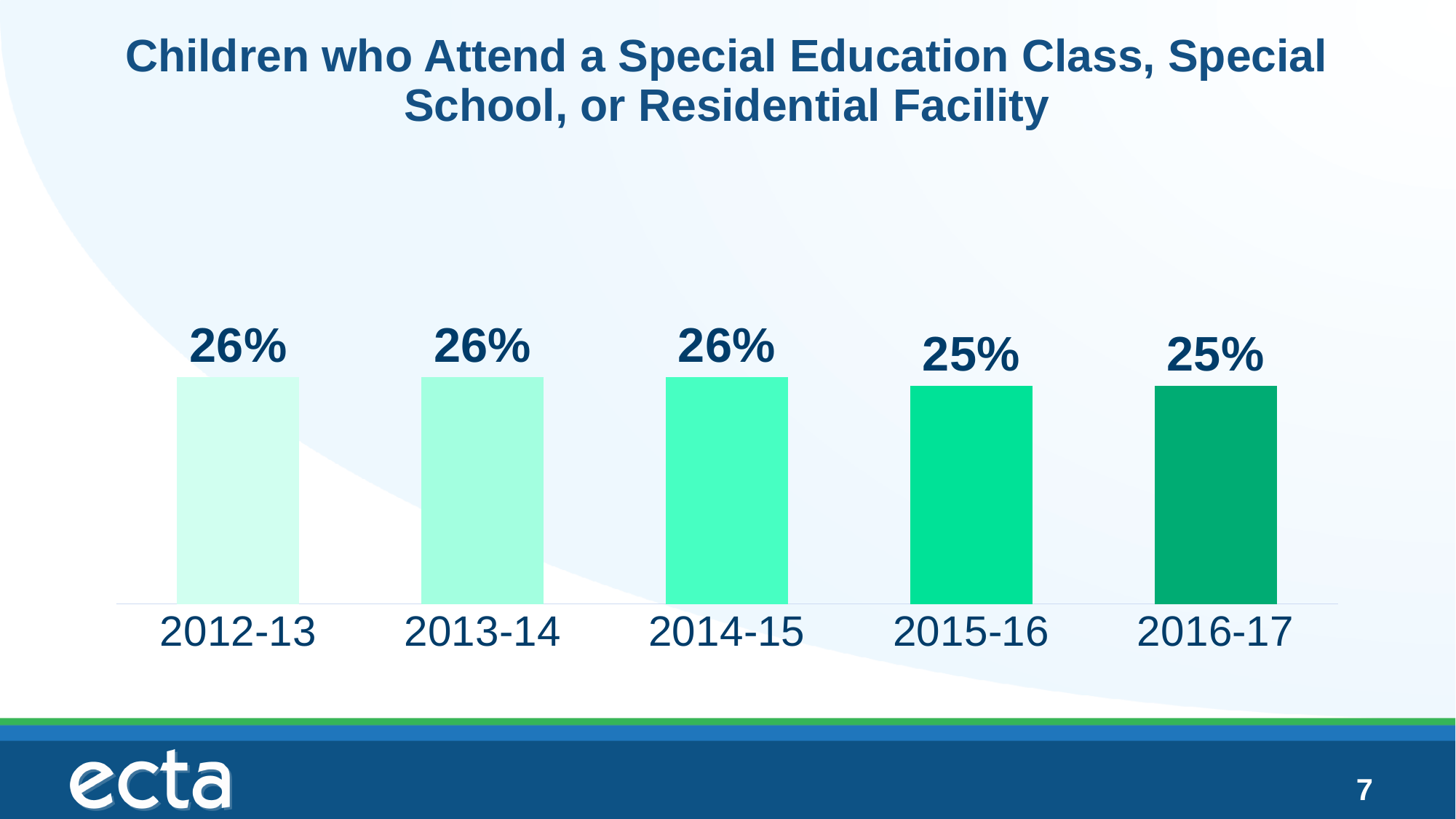
What is the value shown for 2014-15? 26% What is the title of the chart? Children who Attend a Special Education Class, Special School, or Residential Facility Which school year is the first to show a value of 25%? 2015-16 Which school years share the lowest value on the chart? 2015-16 and 2016-17 What percentage of children attended a special education class, special school, or residential facility in 2012-13? 26% Which is larger, the value for 2013-14 or the value for 2015-16? 2013-14 What is the value shown for 2015-16? 25% What kind of chart is shown on the slide? Bar chart What is the value shown for 2016-17? 25% What is the difference between the values for 2012-13 and 2016-17? 1% How many school years are shown on the chart? 5 Do the values rise or fall from 2012-13 to 2016-17? Fall